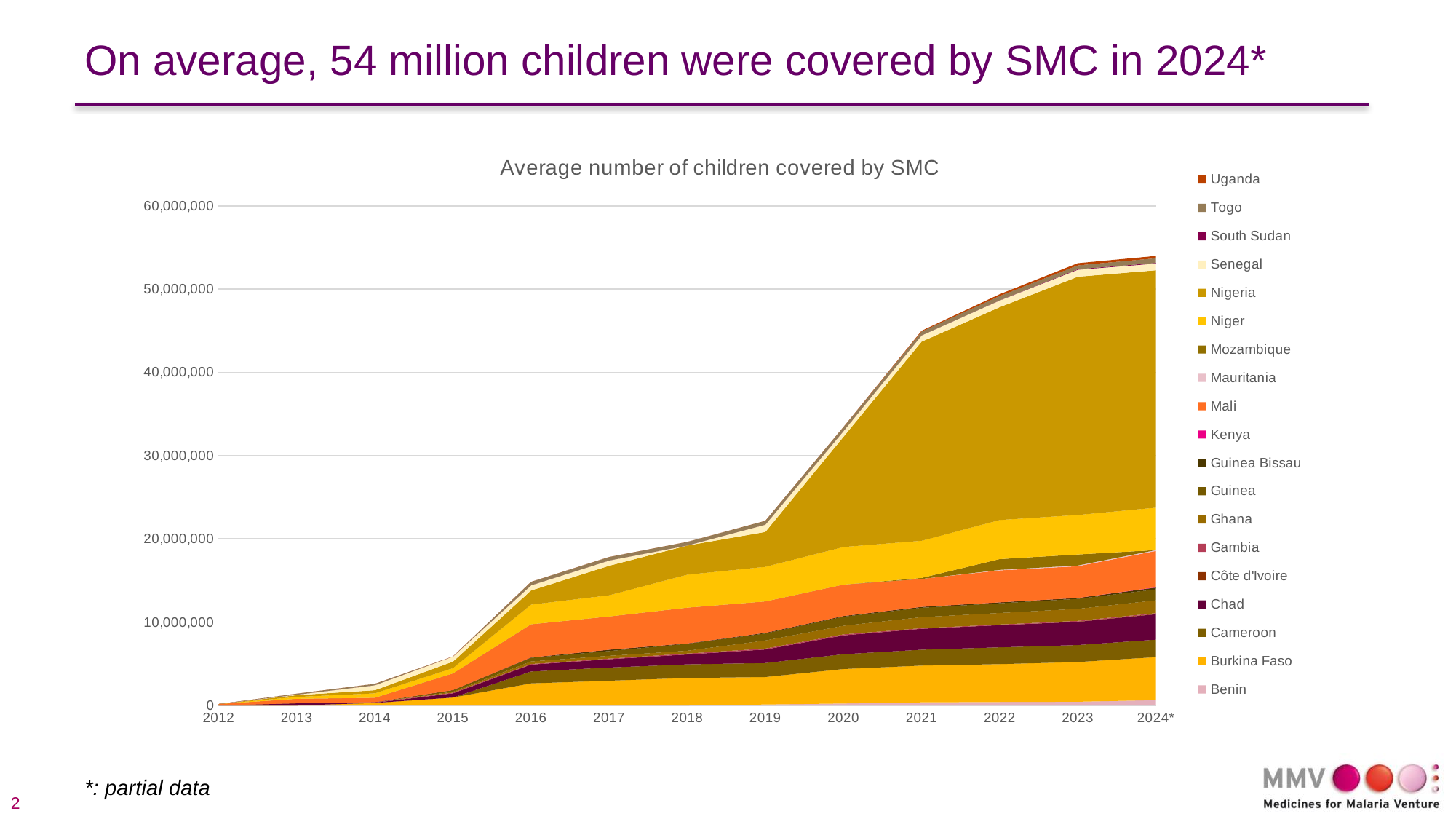
What kind of chart is shown on the slide? Stacked area chart Is the total number of children covered in 2024* greater or less than 50,000,000? greater How many countries are listed in the chart legend? 19 Does the total number of children covered by SMC rise or fall from 2012 to 2024*? Rise Is the total number of children covered in 2021 greater or less than 40,000,000? greater How many years are shown along the x axis of the chart? 13 In which year is the total number of children covered by SMC highest? 2024* Which year has a larger total of children covered by SMC, 2018 or 2023? 2023 What is the title of the chart? Average number of children covered by SMC In which year is the total number of children covered by SMC lowest? 2012 Which country accounts for the largest share of children covered by SMC in 2024*? Nigeria Is the total number of children covered in 2016 greater or less than 20,000,000? less